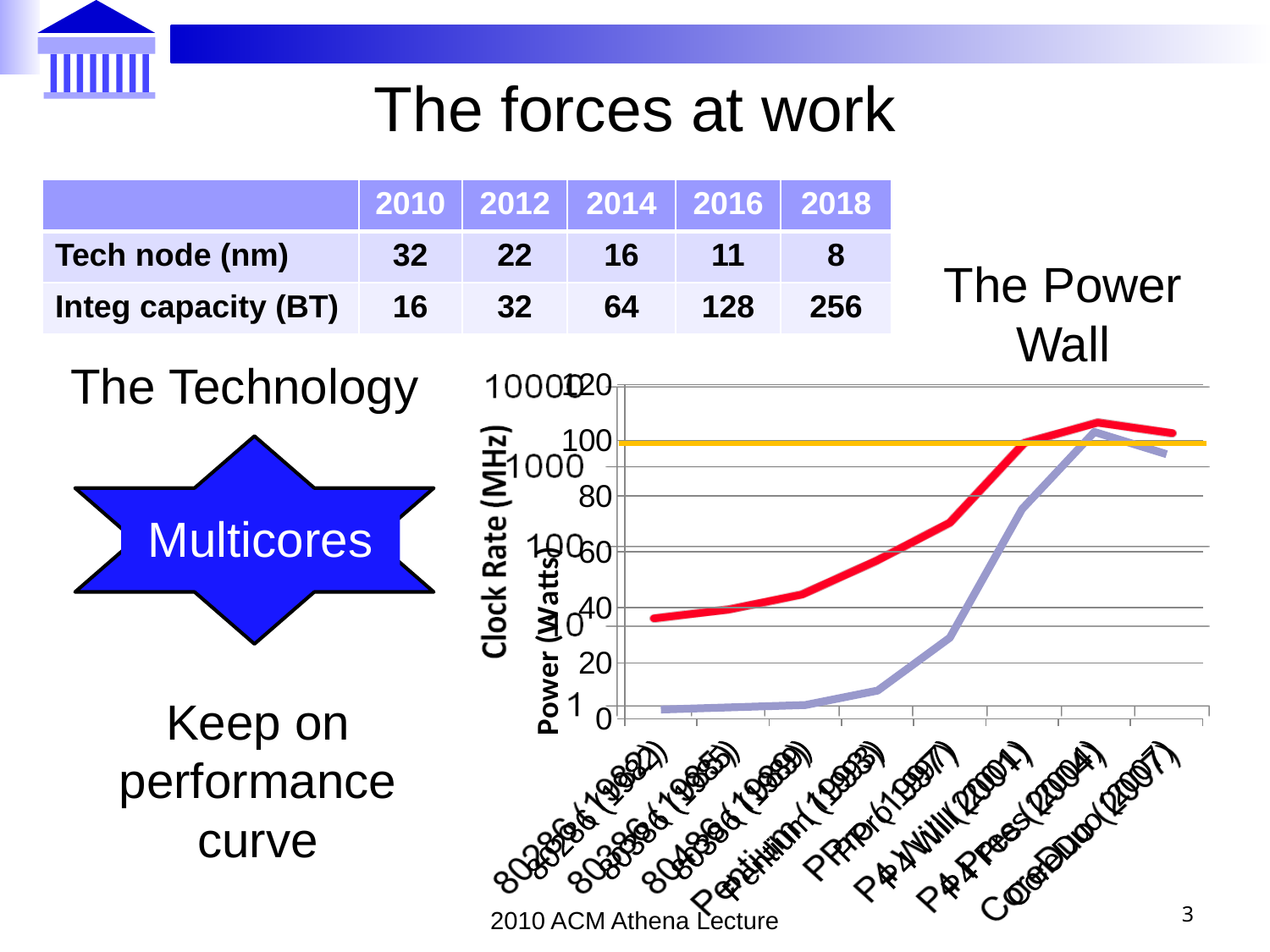
At what value on the Power (Watts) axis is the horizontal yellow line drawn? 100 What is the highest tick value shown on the Power (Watts) axis? 120 What is the title of the left vertical axis of the chart? Clock Rate (MHz) What kind of chart is shown on the slide? line chart What is the title of the second vertical axis, labelled in Watts? Power (Watts) Do the red and blue lines generally rise or fall from left to right across the chart? rise What is the highest tick value shown on the Clock Rate (MHz) axis? 10000 At the leftmost point of the chart, which line is higher, the red line or the blue line? red line